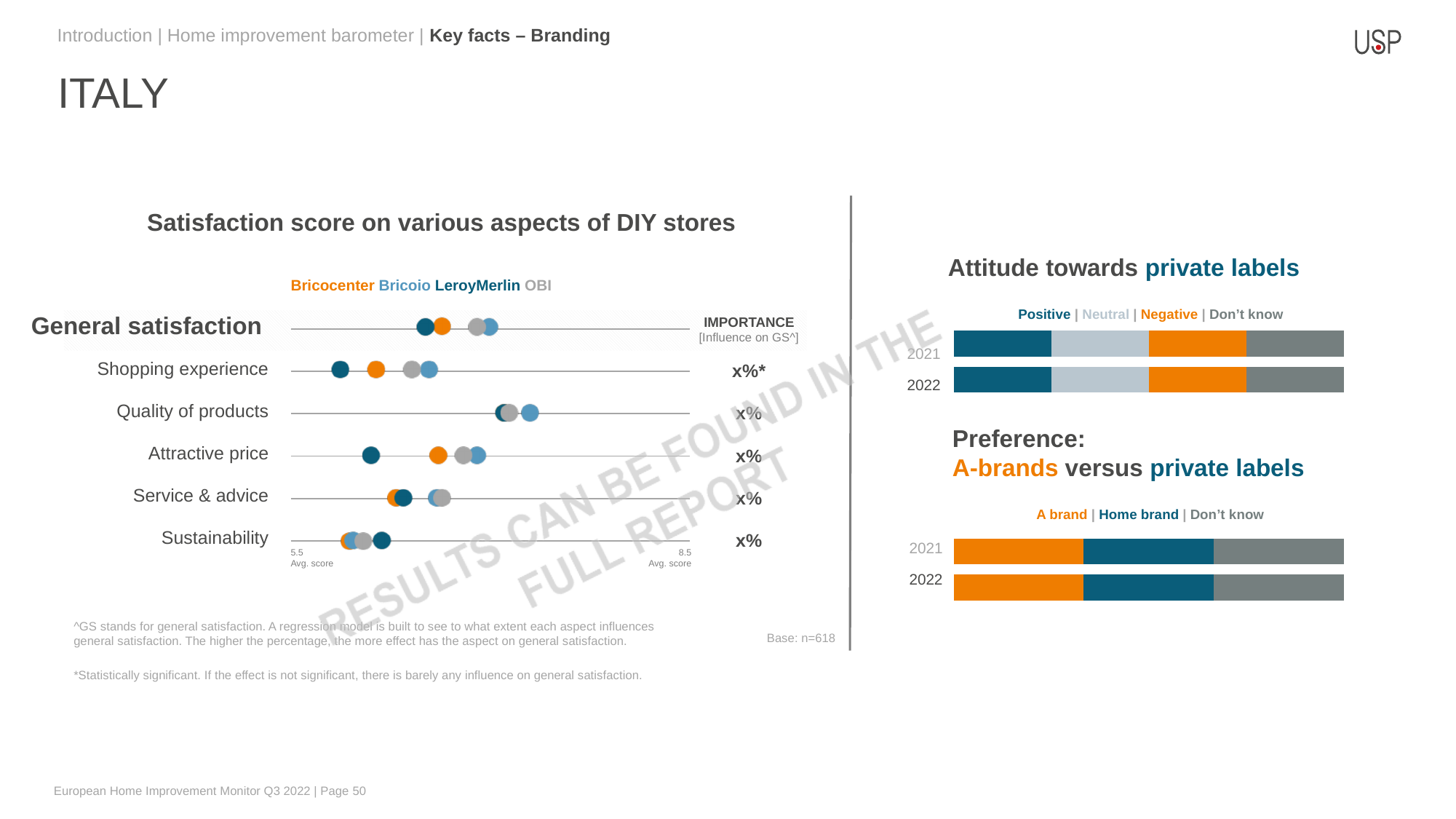
Which years are shown in the 'Attitude towards private labels' chart? 2021 and 2022 How many categories does the legend of the 'Preference: A-brands versus private labels' chart list? 3 In the 'Satisfaction score on various aspects of DIY stores' chart, which store has the lowest score for Attractive price? LeroyMerlin How many aspects (rows) are plotted in the 'Satisfaction score on various aspects of DIY stores' chart? 6 How many categories does the legend of the 'Attitude towards private labels' chart list? 4 What kind of chart is 'Satisfaction score on various aspects of DIY stores'? Dot plot In the 'Satisfaction score on various aspects of DIY stores' chart, for Attractive price, is the score for Bricocenter or LeroyMerlin higher? Bricocenter What is the base (sample size) stated for the charts on the right of the slide? n=618 In the 'Satisfaction score on various aspects of DIY stores' chart, which store has the lowest score for Shopping experience? LeroyMerlin How many store brands does the legend of the 'Satisfaction score on various aspects of DIY stores' chart list? 4 In the 'Satisfaction score on various aspects of DIY stores' chart, which store has the highest score for Sustainability? LeroyMerlin What kind of chart is 'Attitude towards private labels'? Stacked bar chart